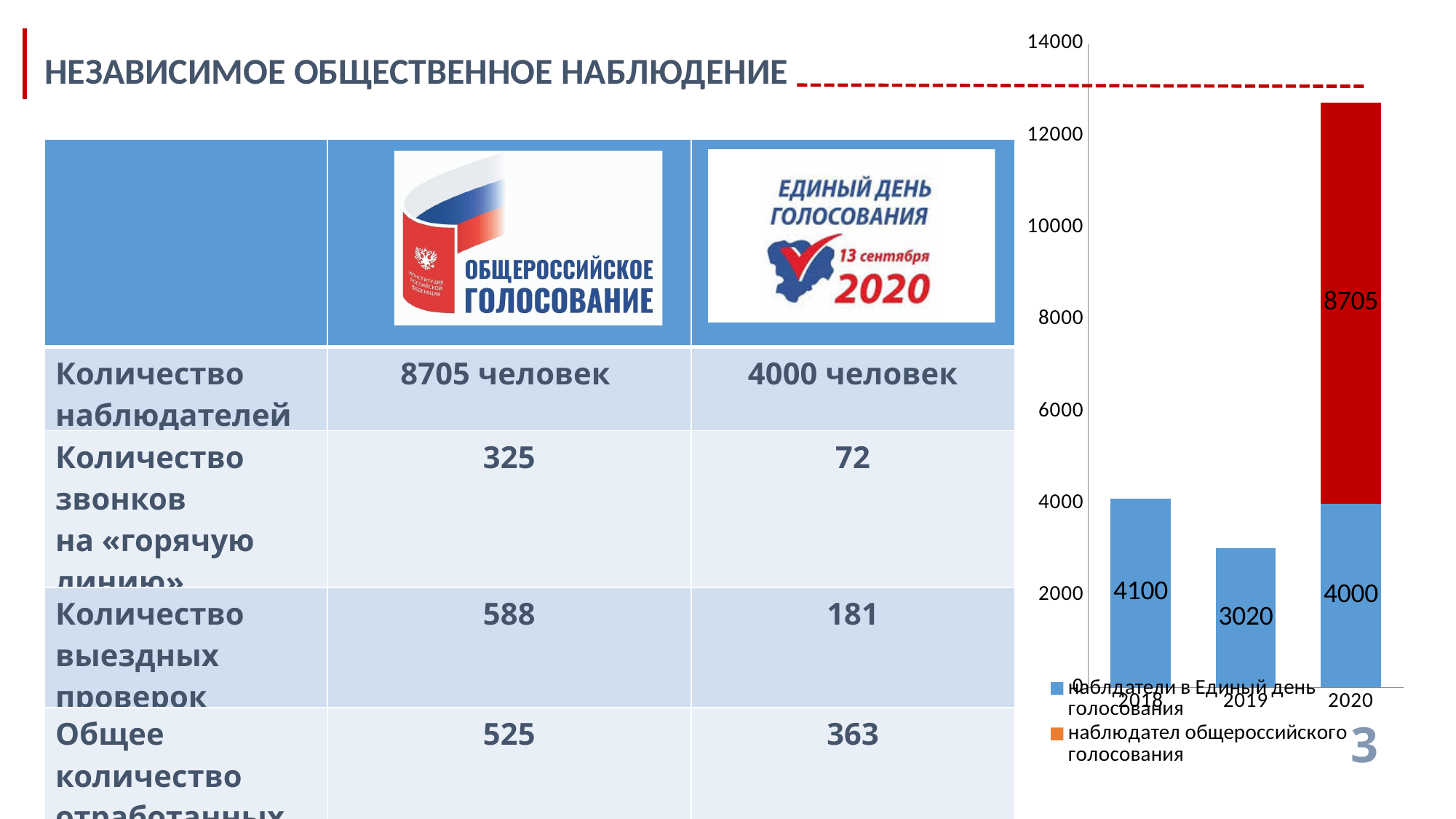
How many series does the chart legend list? 2 What is the total of the stacked bar for 2020 in the chart? 12705 Which year has the lowest blue bar value in the chart? 2019 Is the blue bar value for 2018 larger than the blue bar value for 2020 in the chart? Yes How many years are shown on the x axis of the chart? 3 What is the value of the red segment of the 2020 bar in the chart? 8705 What is the value of the blue segment of the 2020 bar in the chart? 4000 What is the value of the blue bar for 2018 in the chart? 4100 What is the value of the blue bar for 2019 in the chart? 3020 What kind of chart is shown on the slide? Stacked bar chart What is the difference between the blue bar values for 2018 and 2019 in the chart? 1080 Which year has the tallest bar overall in the chart? 2020